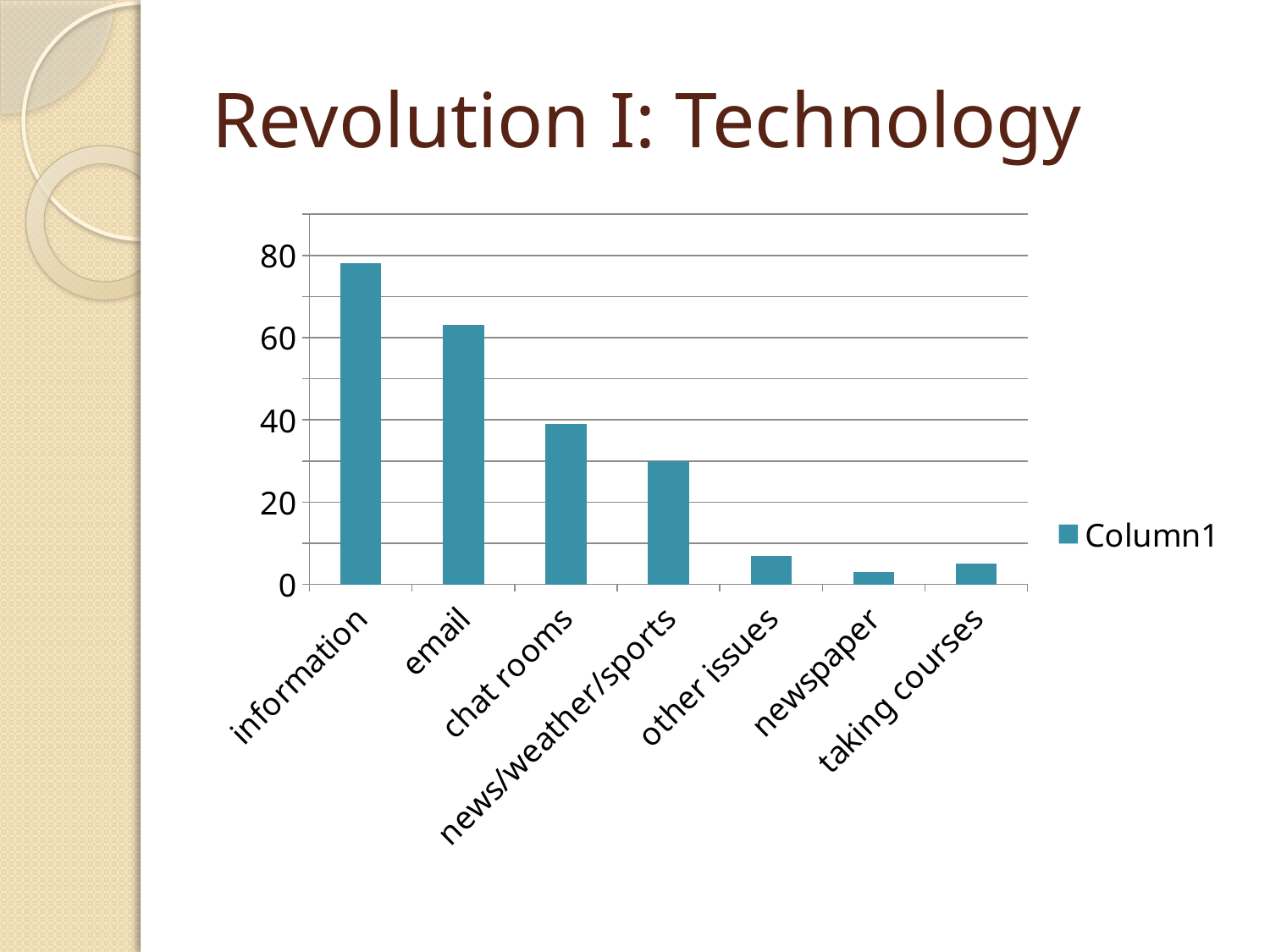
What kind of chart is shown on the slide? bar chart Which category has the highest value in the chart? information Which category has the lowest value in the chart? newspaper How many categories are shown on the x axis of the chart? 7 Is the value for other issues greater or less than 20? less How many series does the chart's legend list? 1 Which is larger, the value for information or the value for email? information Which is larger, the value for chat rooms or the value for news/weather/sports? chat rooms Is the value for news/weather/sports greater or less than 40? less Is the value for email greater or less than 40? greater What is the name of the series shown in the chart's legend? Column1